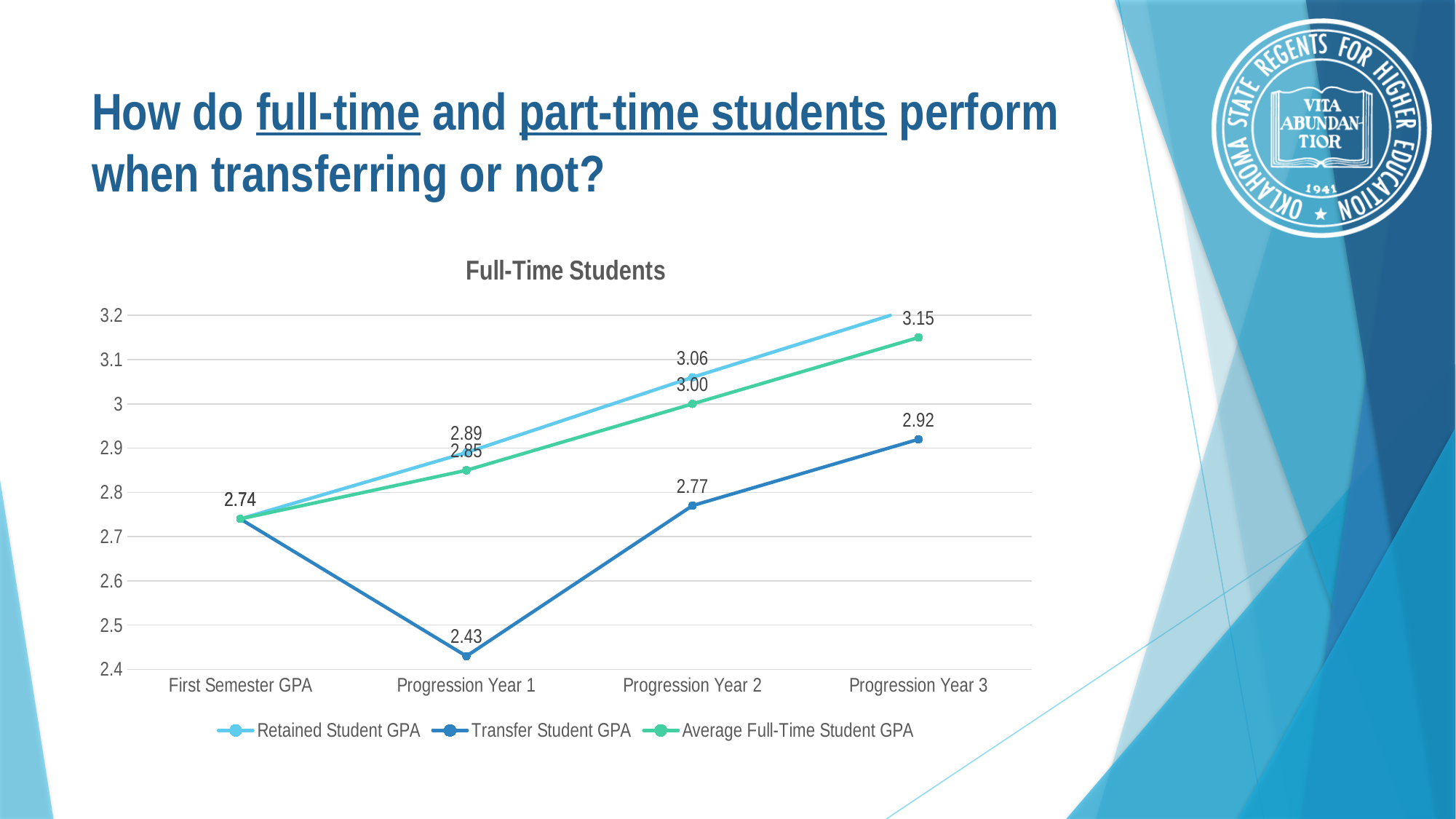
What is the Transfer Student GPA at Progression Year 3? 2.92 What is the difference between the Retained Student GPA and the Transfer Student GPA at Progression Year 1? 0.46 How many categories are shown on the x axis? 4 At Progression Year 2, which is larger: the Retained Student GPA or the Transfer Student GPA? Retained Student GPA Is the Retained Student GPA at Progression Year 3 greater or less than 3.1? greater What is the Transfer Student GPA at Progression Year 1? 2.43 What is the Average Full-Time Student GPA at Progression Year 2? 3.00 What is the Retained Student GPA at Progression Year 2? 3.06 How many series does the legend list? 3 What is the title of the chart? Full-Time Students At which category is the Transfer Student GPA lowest? Progression Year 1 What kind of chart is shown on the slide? line chart